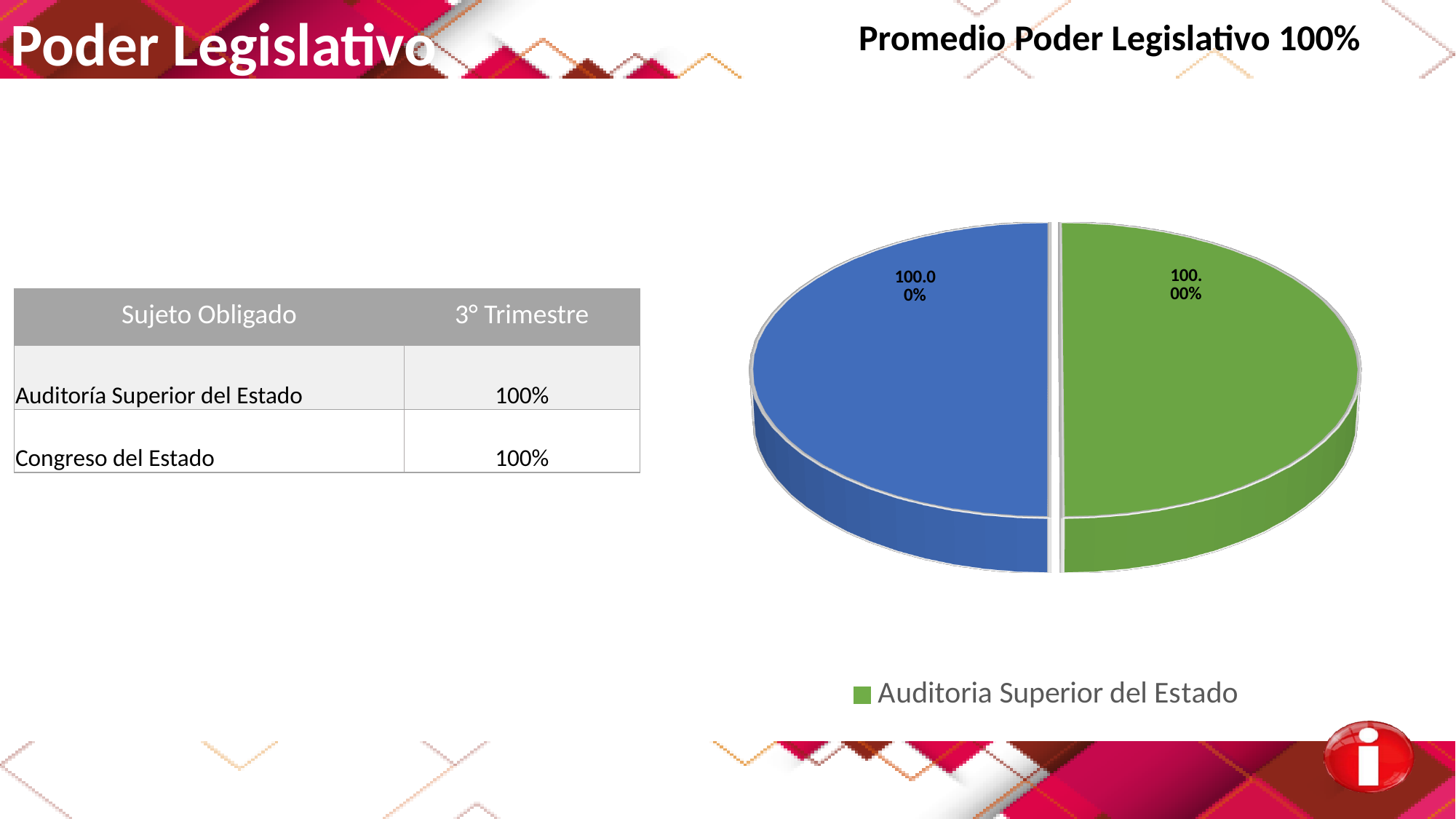
What value is printed on the blue slice of the pie chart? 100.00% What kind of chart is shown on the slide? pie chart What value is printed on the green slice of the pie chart? 100.00% How many entries does the pie chart's legend list? 1 What value does the pie chart show for Auditoria Superior del Estado? 100.00% Which category is listed in the pie chart's legend? Auditoria Superior del Estado How many slices does the pie chart have? 2 What colour represents Auditoria Superior del Estado in the pie chart? green